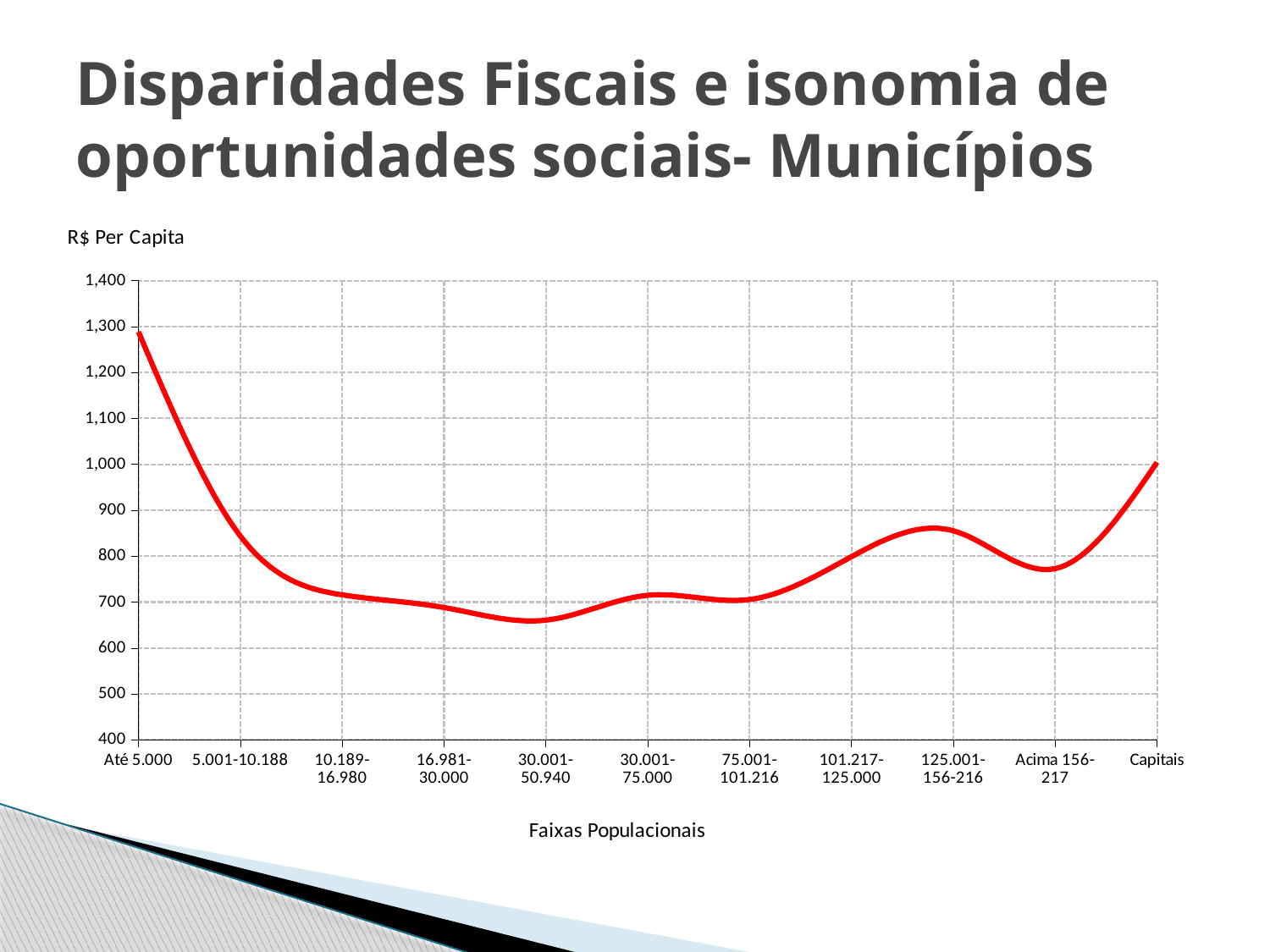
Is the value for 30.001-50.940 greater or less than 700? less Is the value for Capitais greater or less than 900? greater Which population range has the lowest R$ per capita value? 30.001-50.940 What kind of chart is shown on the slide? line chart Is the value for Até 5.000 greater or less than 1,200? greater Do the values rise or fall from Até 5.000 to 30.001-50.940? fall Which has the larger value, Até 5.000 or Capitais? Até 5.000 How many population ranges (categories) are plotted along the x axis? 11 What is the label of the x axis? Faixas Populacionais Which has the larger value, 125.001-156-216 or Acima 156-217? 125.001-156-216 Which population range has the highest R$ per capita value? Até 5.000